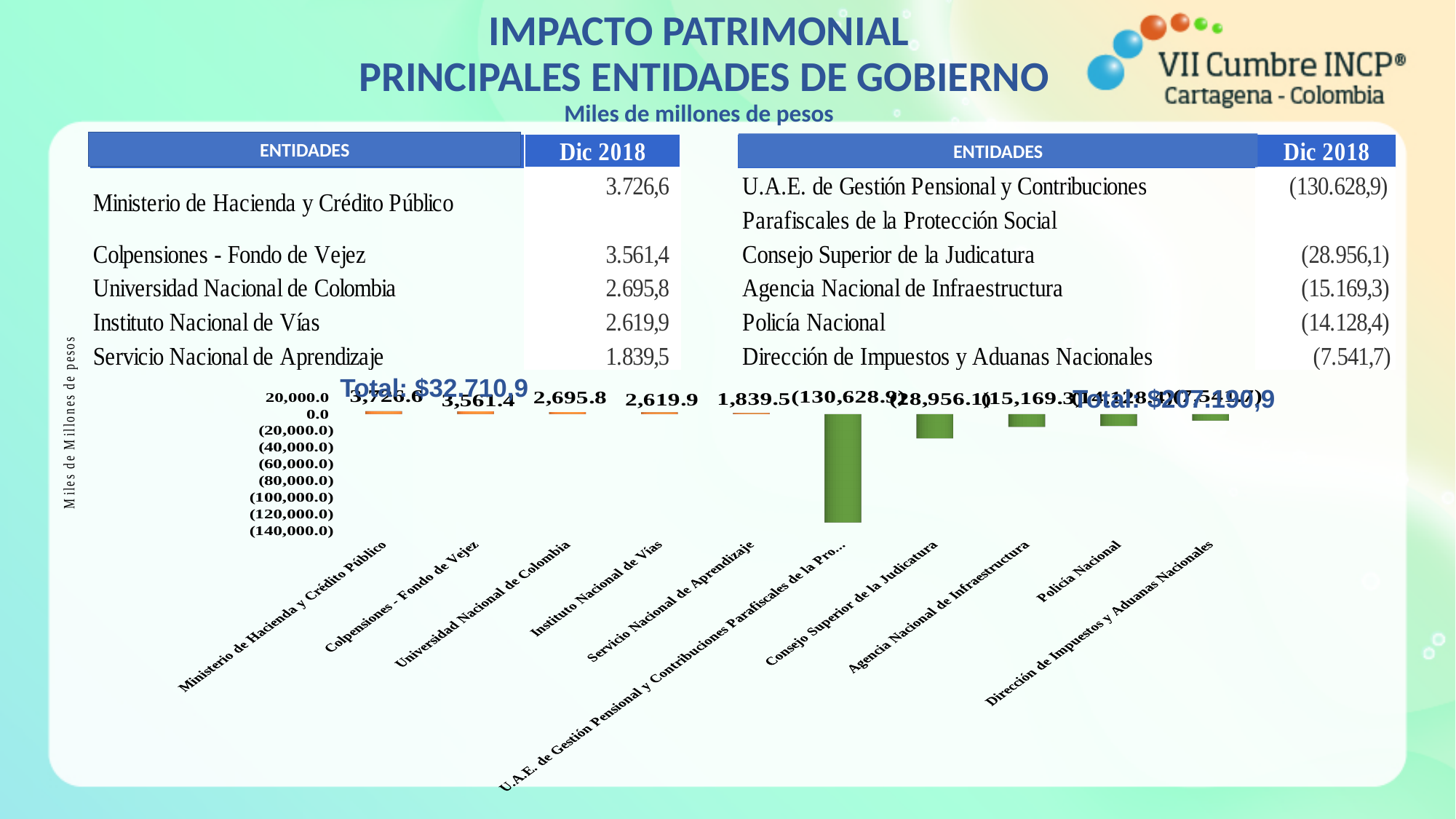
What is the value plotted for Ministerio de Hacienda y Crédito Público in the bar chart? 3,726.6 What is the value plotted for Servicio Nacional de Aprendizaje in the bar chart? 1,839.5 Which has the larger value in the bar chart, Universidad Nacional de Colombia or Instituto Nacional de Vías? Universidad Nacional de Colombia What is the value plotted for Universidad Nacional de Colombia in the bar chart? 2,695.8 What is the title of the vertical axis of the bar chart? Miles de Millones de pesos Which entity has the highest value in the bar chart? Ministerio de Hacienda y Crédito Público What is the value plotted for Instituto Nacional de Vías in the bar chart? 2,619.9 What is the value plotted for Consejo Superior de la Judicatura in the bar chart? (28,956.1) What is the difference between the values for Ministerio de Hacienda y Crédito Público and Colpensiones - Fondo de Vejez in the bar chart? 165.2 Which entity has the lowest (most negative) value in the bar chart? U.A.E. de Gestión Pensional y Contribuciones Parafiscales de la Protección Social What kind of chart is shown on the slide? bar chart How many entities (categories) are plotted in the bar chart? 10